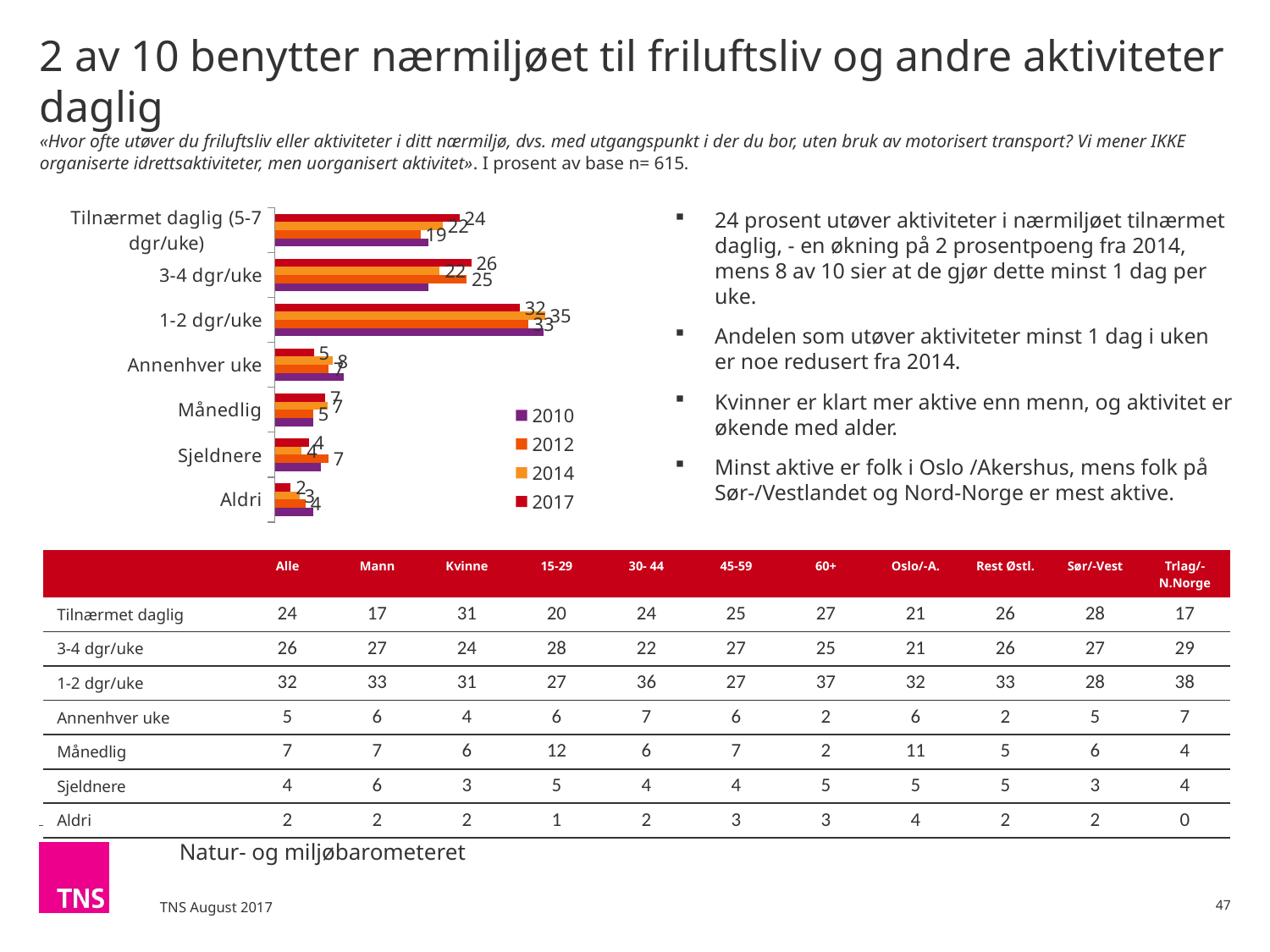
What is the 2017 value for '3-4 dgr/uke' in the chart? 26 Which category has the lowest 2017 value in the chart? Aldri Which category has the highest 2017 value in the chart? 1-2 dgr/uke For 2017, which is larger: the value for 'Månedlig' or the value for 'Annenhver uke'? Månedlig How many categories are shown on the chart's vertical axis? 7 Which years are listed in the chart legend? 2010, 2012, 2014, 2017 What kind of chart is shown on the slide? bar chart What is the 2017 value for 'Aldri' in the chart? 2 What is the 2017 value for '1-2 dgr/uke' in the chart? 32 How many series does the chart legend list? 4 What is the difference between the 2017 values for '1-2 dgr/uke' and 'Tilnærmet daglig (5-7 dgr/uke)'? 8 What is the 2017 value for 'Tilnærmet daglig (5-7 dgr/uke)' in the chart? 24